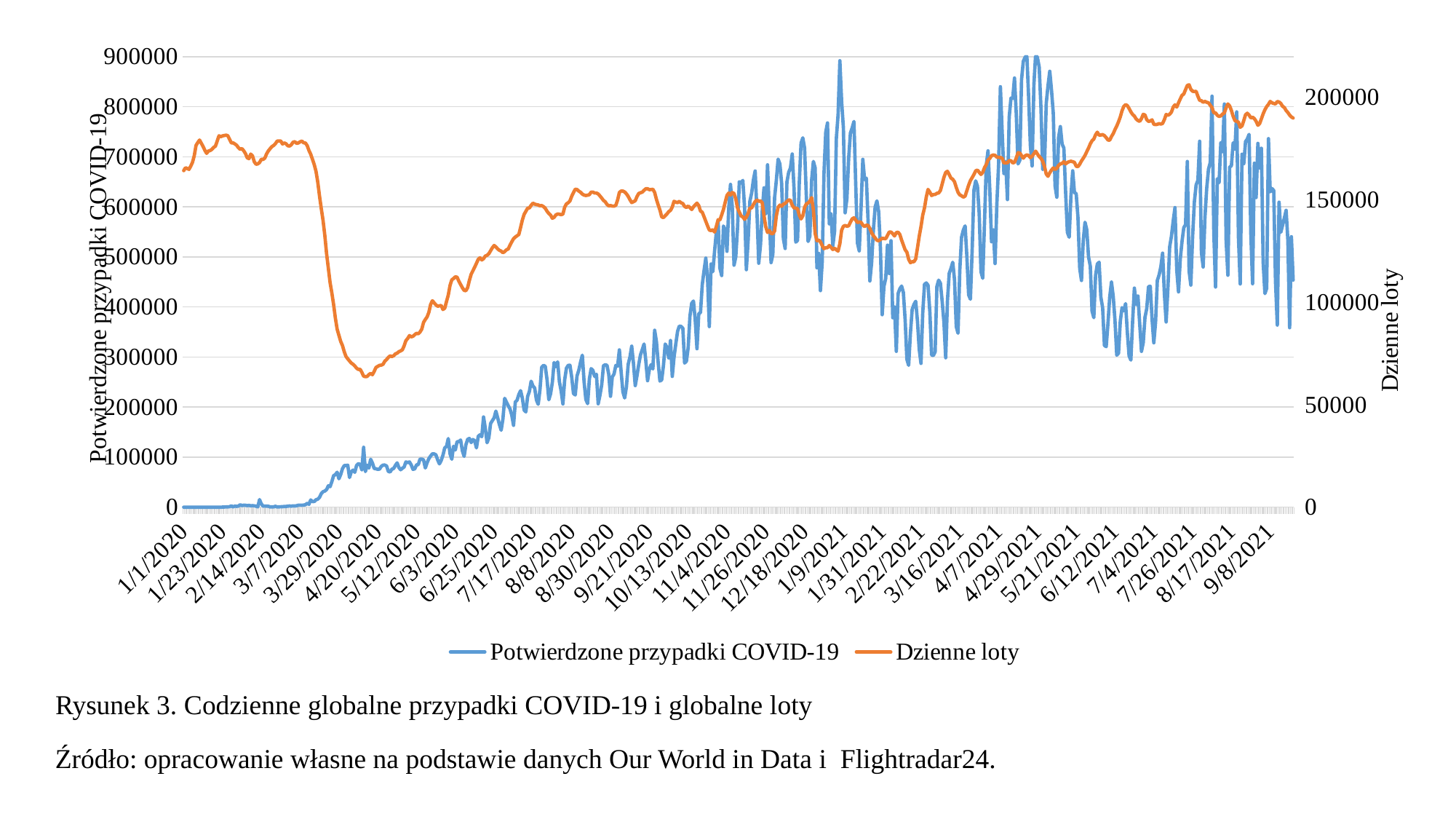
Does the Dzienne loty line rise or fall between 3/7/2020 and 4/20/2020? fall Is the value for Dzienne loty on 9/8/2021 greater or less than 150000? greater Is the highest value reached by Potwierdzone przypadki COVID-19 greater or less than 800000? greater Is the value for Dzienne loty on 4/20/2020 greater or less than 100000? less Does the Potwierdzone przypadki COVID-19 line rise or fall between 1/1/2020 and 11/4/2020? rise What kind of chart is shown on the slide? Line chart Which series is plotted against the right-hand axis labelled "Dzienne loty"? Dzienne loty What is the caption of the figure below the chart? Rysunek 3. Codzienne globalne przypadki COVID-19 i globalne loty How many series does the legend list? 2